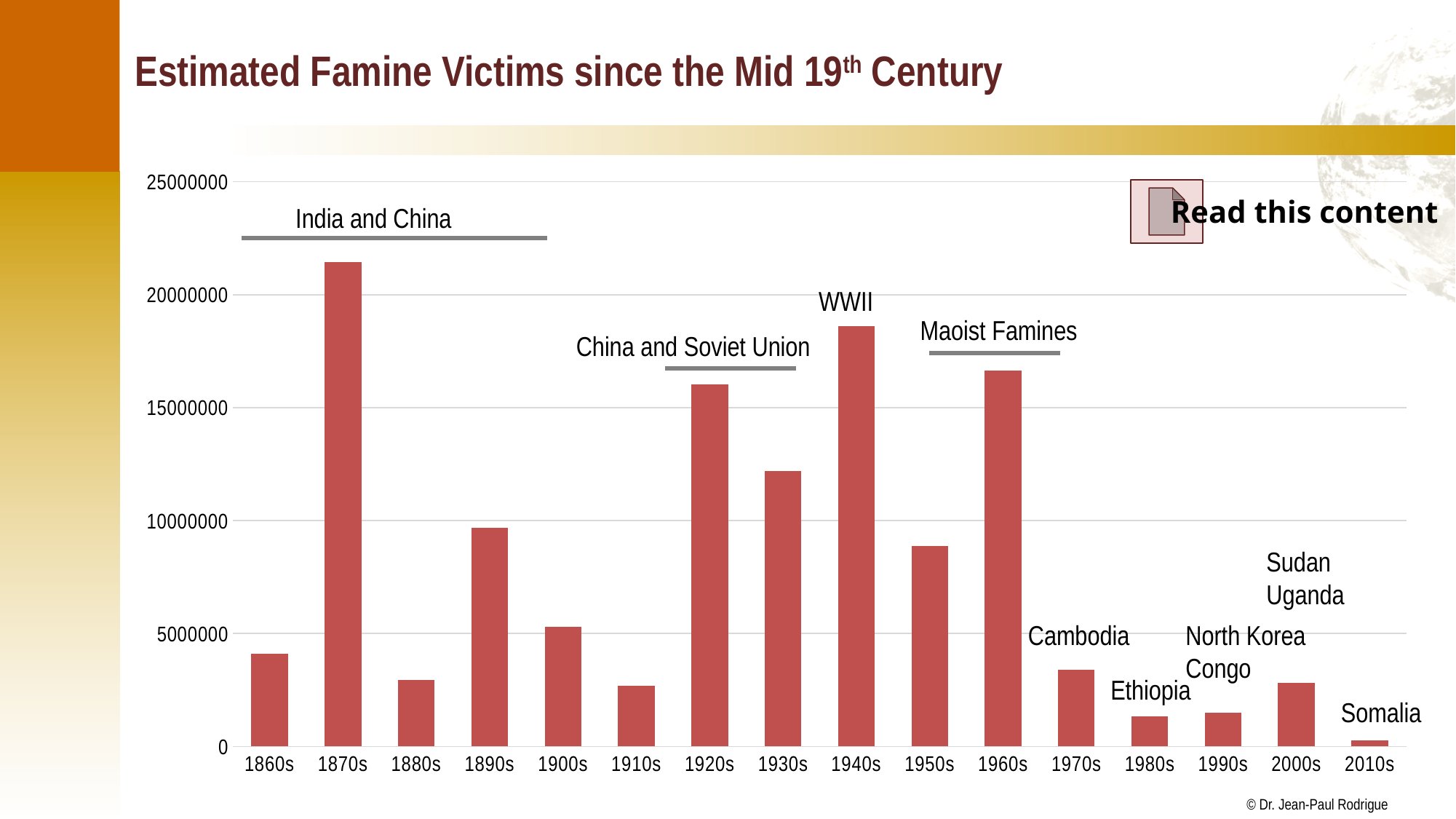
Which decade has the highest estimated number of famine victims? 1870s Is the value for the 1870s greater or less than 20000000? greater What kind of chart is shown on the slide? Bar chart Is the value for the 1940s greater or less than 15000000? greater What is the title of the chart? Estimated Famine Victims since the Mid 19th Century Is the value for the 1890s greater or less than 10000000? less Which decade has the larger value, the 1940s or the 1960s? 1940s How many decades are plotted on the x axis? 16 Which decade has the larger value, the 1930s or the 1950s? 1930s Which decade's bar is labelled with the annotation "WWII"? 1940s Which decade has the lowest estimated number of famine victims? 2010s